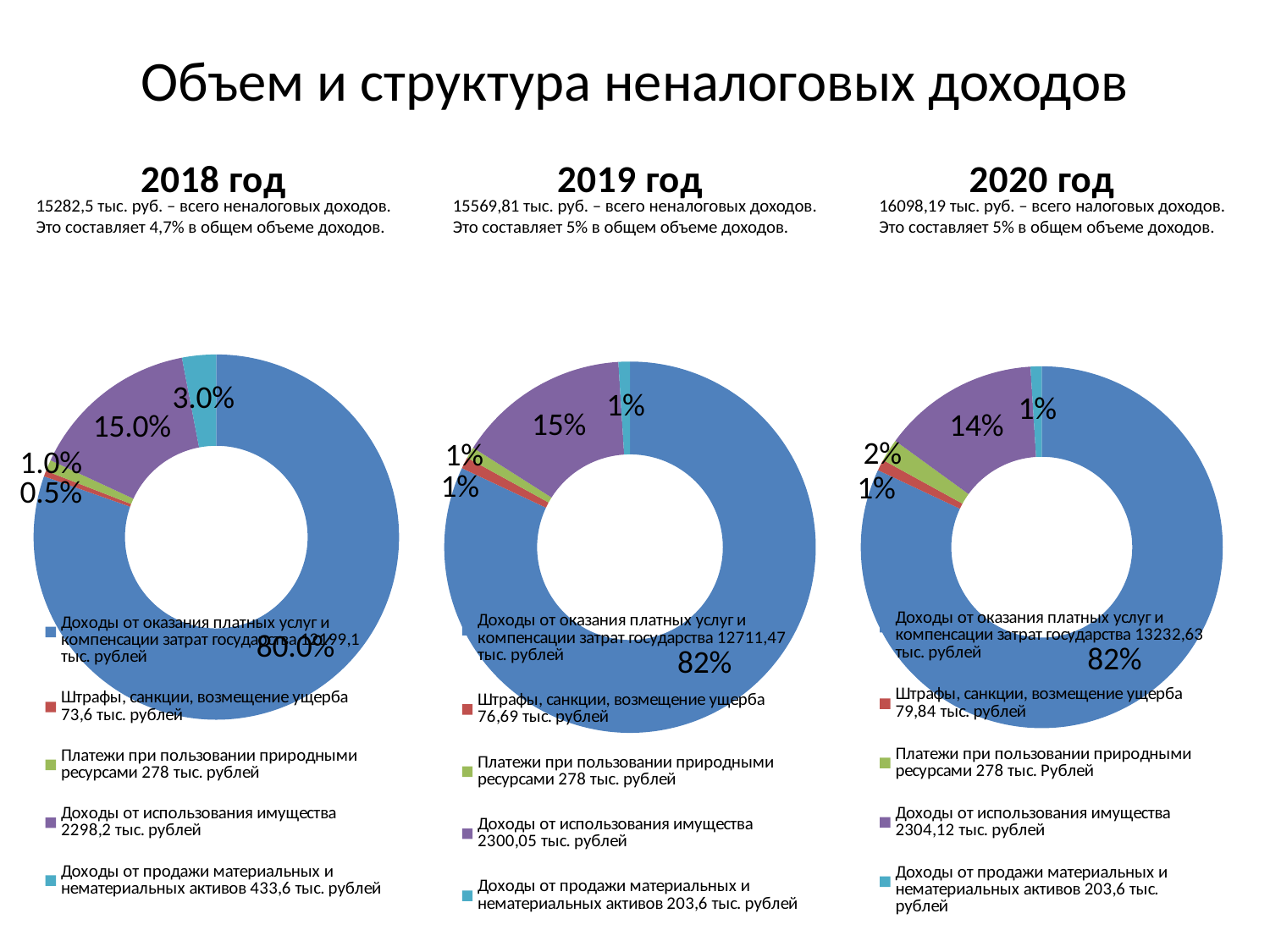
In the 2018 год chart, what share is labelled for Доходы от продажи материальных и нематериальных активов? 3.0% In the 2018 год chart, what share is labelled for Доходы от использования имущества? 15.0% What type of chart is used for the 2018 год chart? doughnut chart In the 2020 год chart, what value does the legend give for Доходы от использования имущества? 2304,12 тыс. рублей In the 2018 год chart, what share is labelled for the largest slice (Доходы от оказания платных услуг и компенсации затрат государства)? 80.0% In the 2020 год chart, which category has the largest slice? Доходы от оказания платных услуг и компенсации затрат государства In the 2019 год chart, what value does the legend give for Штрафы, санкции, возмещение ущерба? 76,69 тыс. рублей In the 2018 год chart, which category has the smallest slice? Штрафы, санкции, возмещение ущерба How many categories does the legend of the 2019 год chart list? 5